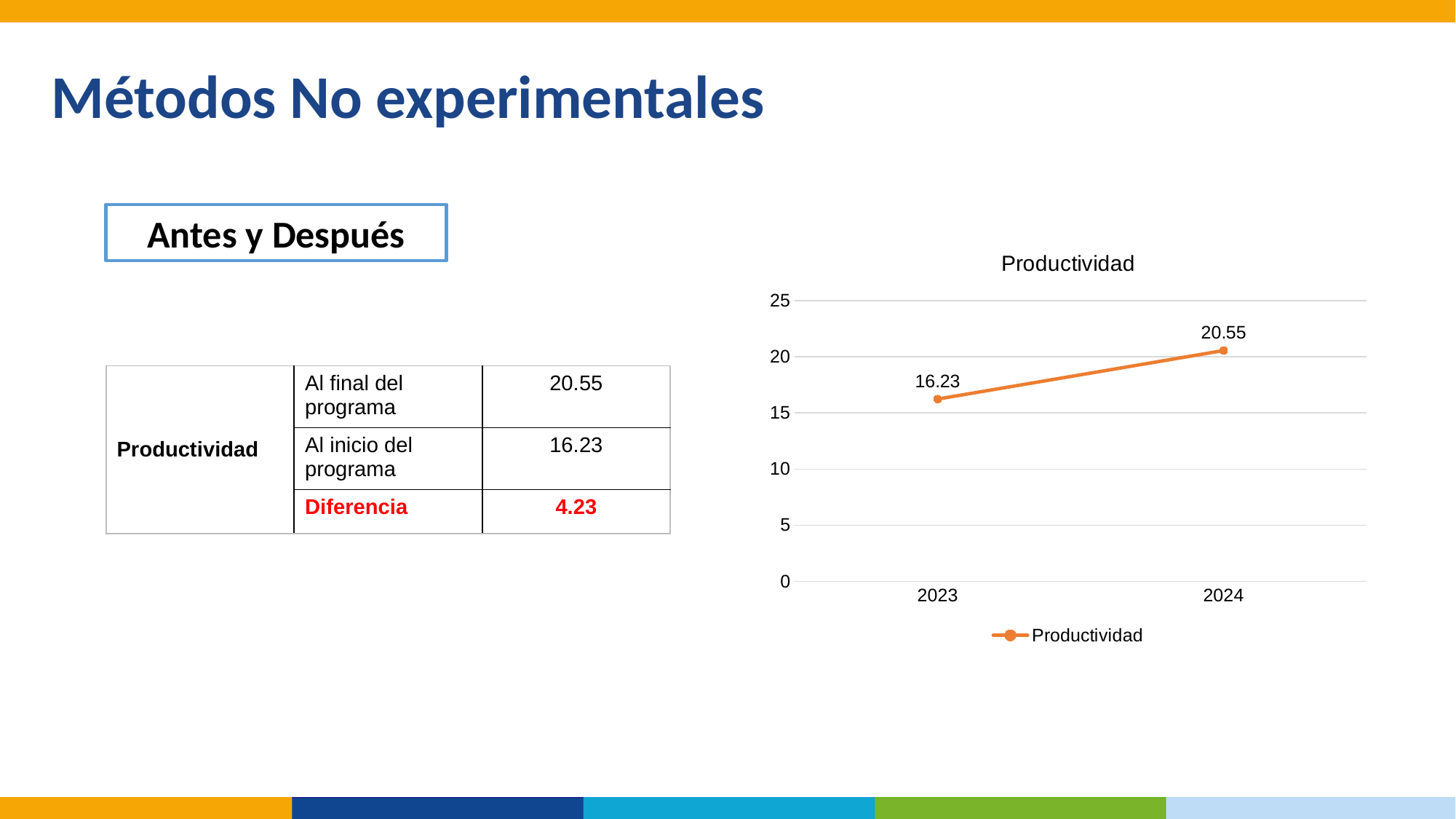
What is the difference between the 2024 and 2023 values in the Productividad chart? 4.32 What is the value for 2024 in the Productividad chart? 20.55 Is the value for 2023 greater or less than 20? less What is the value for 2023 in the Productividad chart? 16.23 What kind of chart is shown on the slide? line chart Which year has the highest value in the Productividad chart? 2024 Do the values rise or fall from 2023 to 2024 in the Productividad chart? rise How many data points are plotted in the Productividad chart? 2 Is the value for 2023 larger or smaller than the value for 2024 in the Productividad chart? smaller Which year has the lowest value in the Productividad chart? 2023 Is the value for 2024 greater or less than 20? greater How many series does the legend of the Productividad chart list? 1